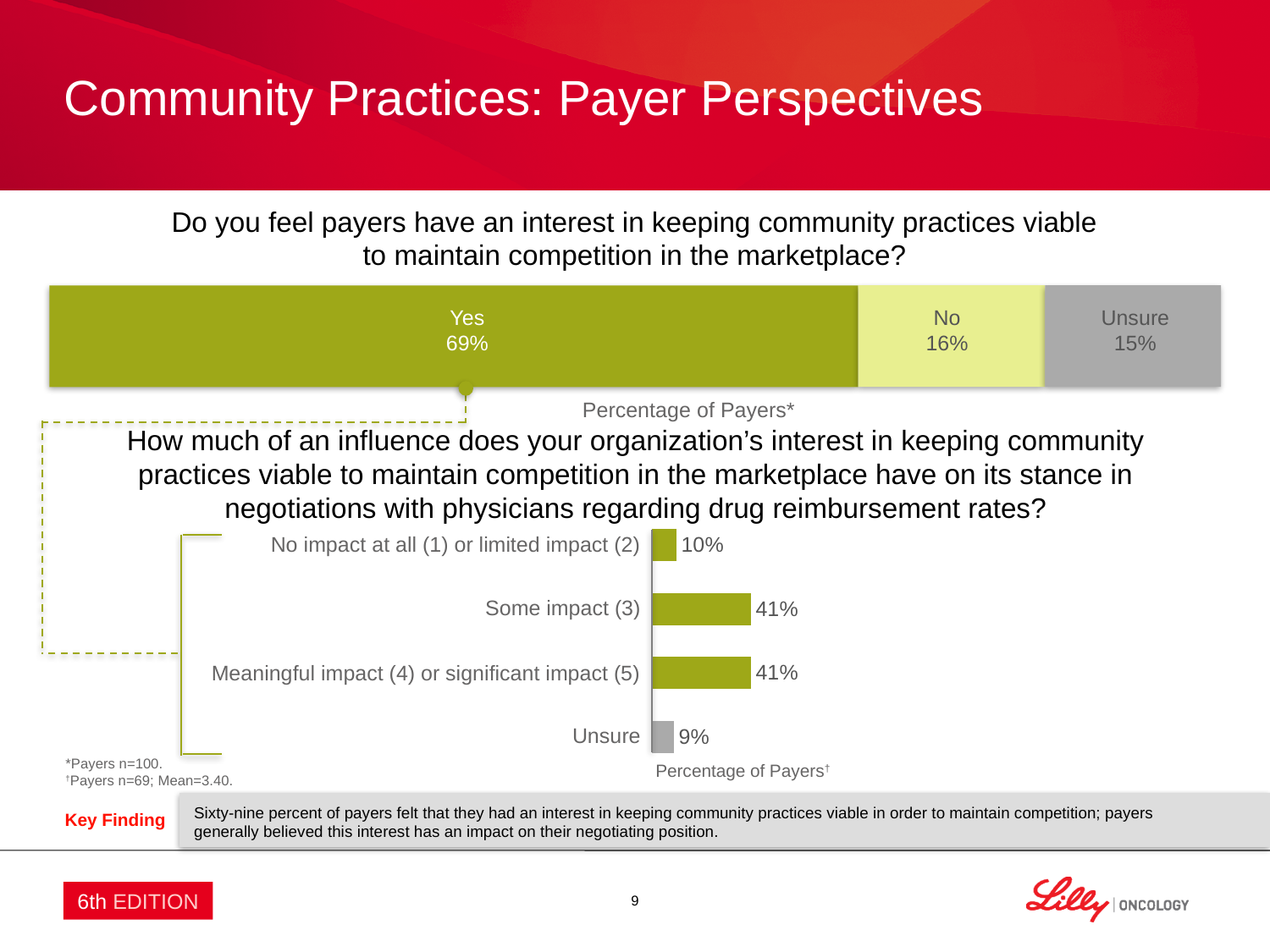
In the bottom chart, what percentage of payers chose 'No impact at all (1) or limited impact (2)'? 10% In the top chart, which response has the highest percentage? Yes In the top chart, what percentage of payers answered No? 16% In the top chart, what percentage of payers answered Yes? 69% In the top chart, what percentage of payers answered Unsure? 15% What type of chart is the bottom chart? Bar chart In the bottom chart, how many categories are plotted? 4 In the bottom chart, which is larger: 'No impact at all (1) or limited impact (2)' or 'Meaningful impact (4) or significant impact (5)'? Meaningful impact (4) or significant impact (5) In the bottom chart, which category has the lowest percentage? Unsure In the bottom chart, what percentage of payers chose 'Some impact (3)'? 41% In the top chart, what is the difference between the Yes and No percentages? 53% In the top chart, how many response categories are shown? 3